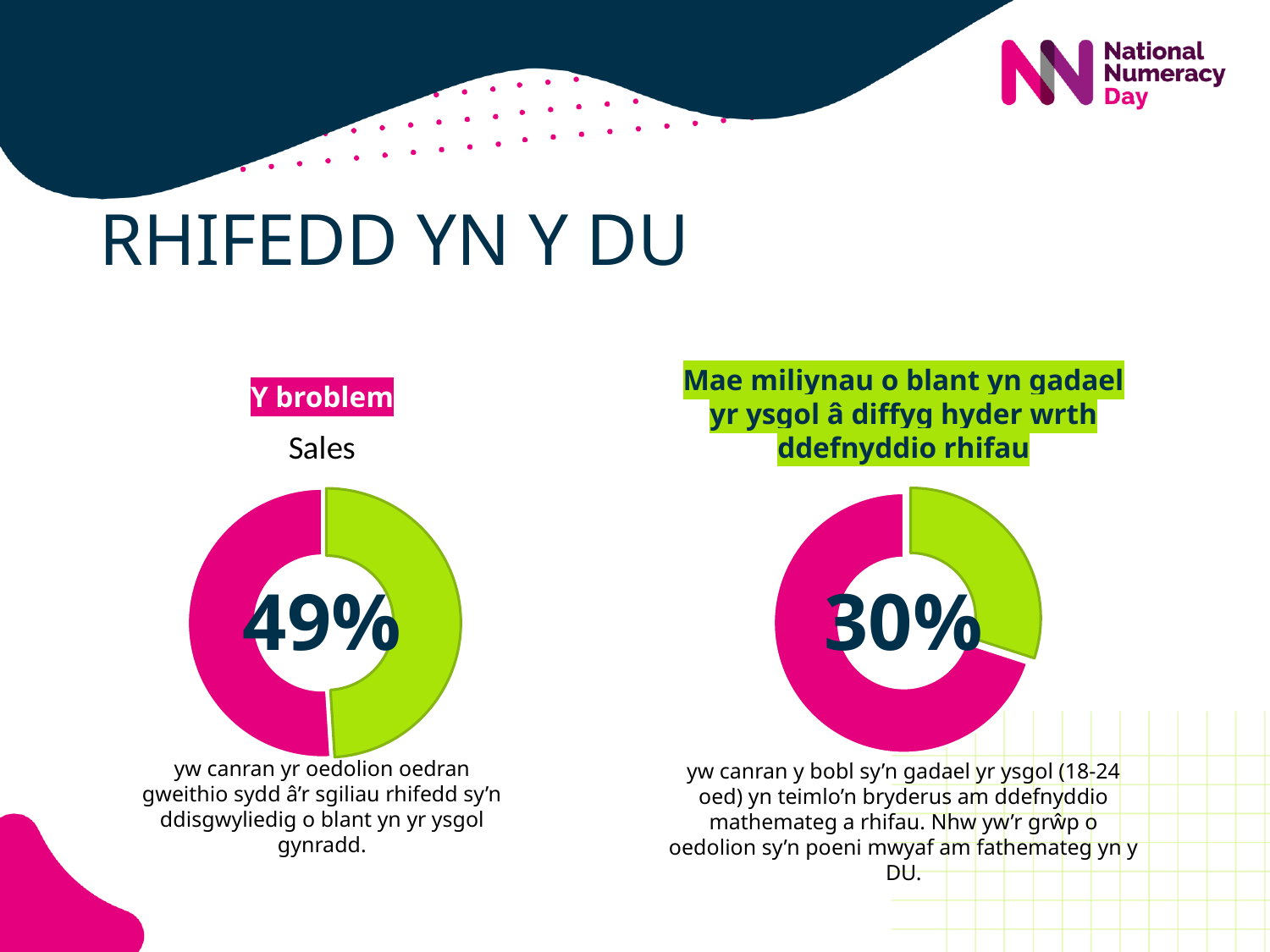
Is the percentage shown in the right chart greater or less than 50%? less What is the difference between the percentage shown in the left chart and the percentage shown in the right chart? 19% What two colours are used for the slices in the left chart titled 'Sales'? Pink and green In the right chart, which slice is larger, the pink one or the green one? The pink one What kind of chart is shown on the left of the slide, under the heading 'Sales'? Doughnut chart What percentage is printed in the centre of the left chart titled 'Sales'? 49% What is the title printed above the left chart? Sales Which chart shows the larger central percentage, the left chart ('Sales') or the right chart? The left chart What percentage is printed in the centre of the right chart? 30% How many slices does the right chart have? 2 How many slices does the left chart titled 'Sales' have? 2 What kind of chart is shown on the right of the slide, under the green heading? Doughnut chart